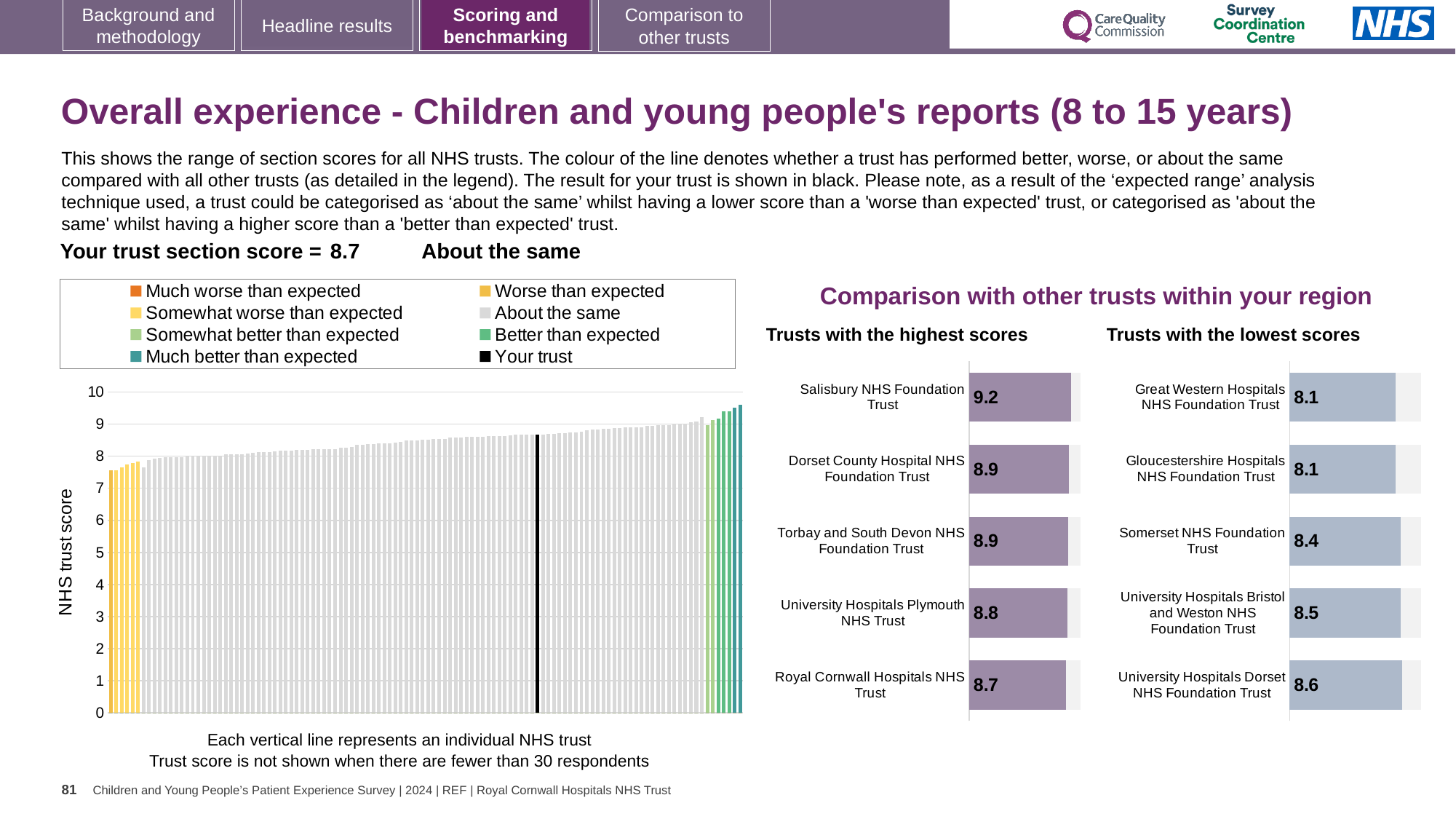
How many entries does the legend of the NHS trust score chart on the left list? 8 In the 'Trusts with the highest scores' chart, which trust has the highest score? Salisbury NHS Foundation Trust In the 'Trusts with the lowest scores' chart, what is the score for Somerset NHS Foundation Trust? 8.4 What type of chart is the NHS trust score chart on the left? Bar chart In the 'Trusts with the lowest scores' chart, what is the difference between the scores of University Hospitals Dorset NHS Foundation Trust and Great Western Hospitals NHS Foundation Trust? 0.5 In the NHS trust score chart on the left, do the values rise or fall from left to right? Rise In the 'Trusts with the highest scores' chart, what is the score for Salisbury NHS Foundation Trust? 9.2 How many trusts are shown in the 'Trusts with the highest scores' chart? 5 In the 'Trusts with the highest scores' chart, what is the difference between the scores of Salisbury NHS Foundation Trust and Royal Cornwall Hospitals NHS Trust? 0.5 Which has a higher score: University Hospitals Plymouth NHS Trust in the 'highest scores' chart or University Hospitals Bristol and Weston NHS Foundation Trust in the 'lowest scores' chart? University Hospitals Plymouth NHS Trust In the 'Trusts with the lowest scores' chart, which trust has the highest score? University Hospitals Dorset NHS Foundation Trust In the NHS trust score chart on the left, is the value of the leftmost bar greater or less than 8? less